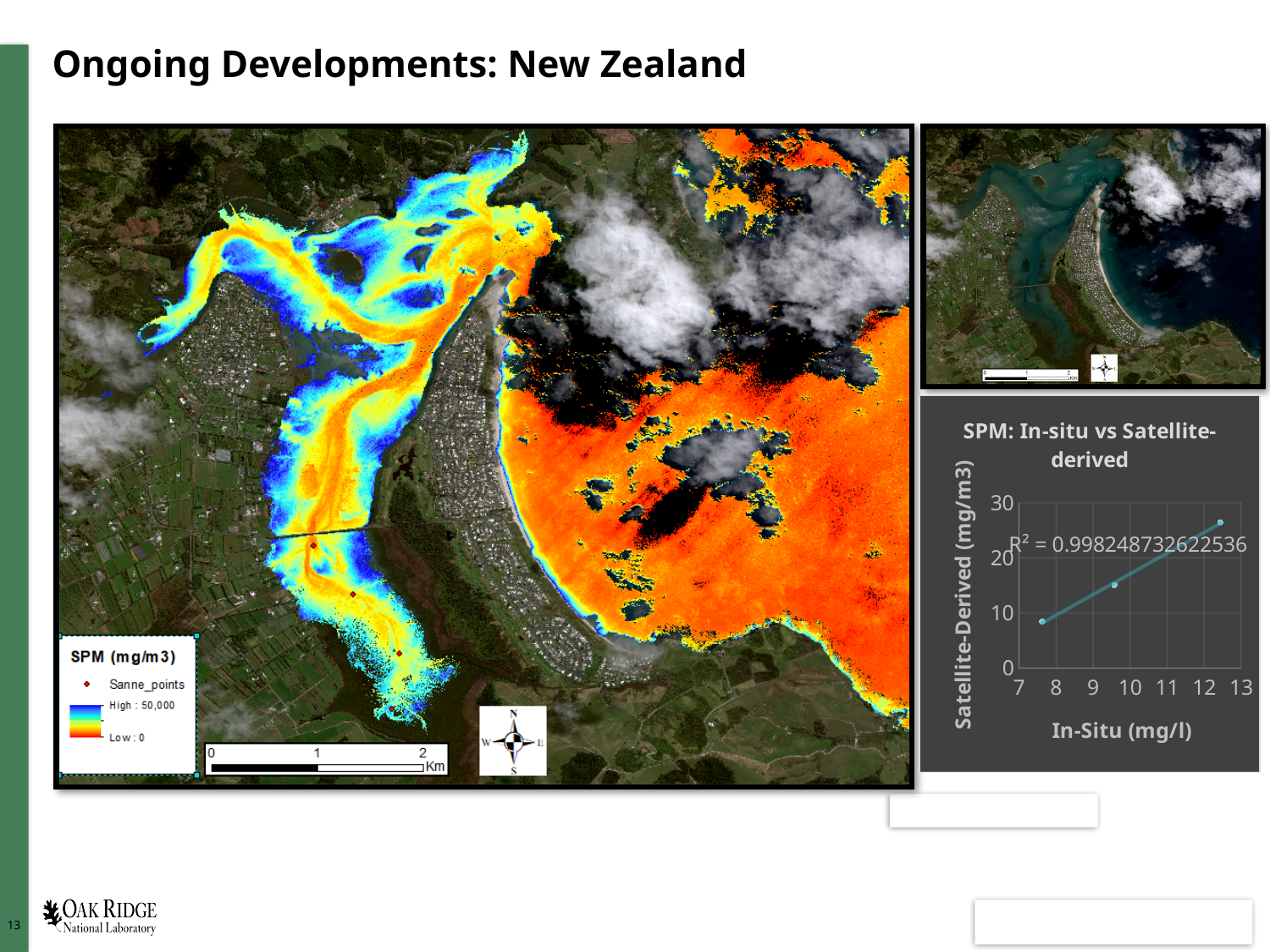
In the 'SPM: In-situ vs Satellite-derived' chart, is the middle data point's satellite-derived value greater or less than 20? less In the 'SPM: In-situ vs Satellite-derived' chart, is the lowest satellite-derived value greater or less than 10? less What is the y-axis label of the 'SPM: In-situ vs Satellite-derived' chart? Satellite-Derived (mg/m3) In the 'SPM: In-situ vs Satellite-derived' chart, which point has the larger satellite-derived value: the one with the smallest in-situ value or the one with the largest in-situ value? the one with the largest in-situ value In the 'SPM: In-situ vs Satellite-derived' chart, is the in-situ value of the lowest point greater or less than 8? less What is the R² value shown on the 'SPM: In-situ vs Satellite-derived' chart? R² = 0.998248732622536 In the 'SPM: In-situ vs Satellite-derived' chart, do the satellite-derived values rise or fall as the in-situ values increase? rise What kind of chart is 'SPM: In-situ vs Satellite-derived'? scatter chart What is the x-axis label of the 'SPM: In-situ vs Satellite-derived' chart? In-Situ (mg/l) How many data points are plotted in the 'SPM: In-situ vs Satellite-derived' chart? 3